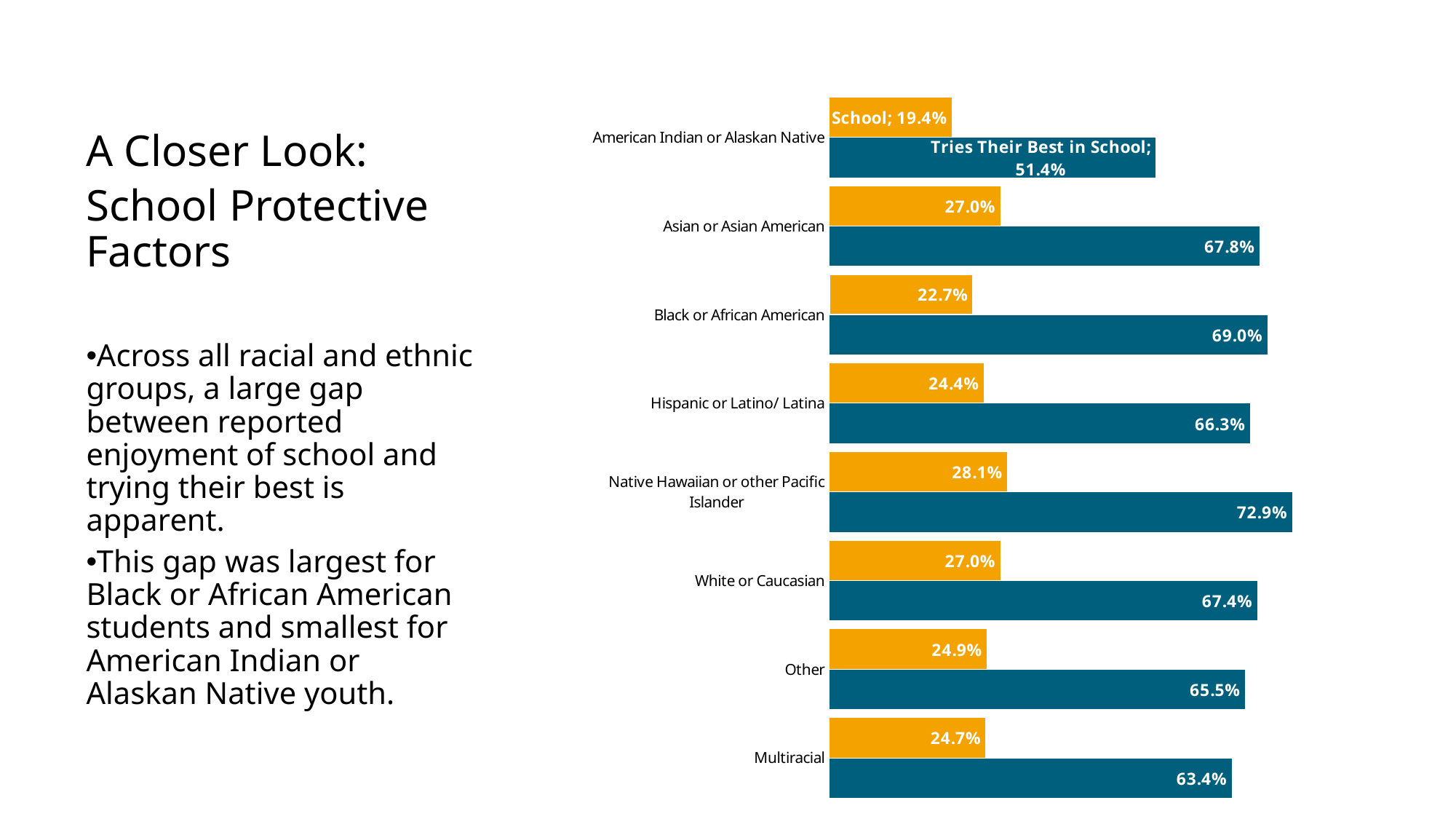
What is the difference between the 'Tries Their Best in School' value and the orange 'School' value for American Indian or Alaskan Native students? 32.0 percentage points What is the value of the 'Tries Their Best in School' bar for Multiracial students? 63.4% Which is larger: the 'Tries Their Best in School' value for Hispanic or Latino/ Latina students or for Other students? Hispanic or Latino/ Latina Which group has the lowest 'Tries Their Best in School' value? American Indian or Alaskan Native Which group has the highest 'Tries Their Best in School' value? Native Hawaiian or other Pacific Islander What is the value of the orange 'School' bar for American Indian or Alaskan Native students? 19.4% What type of chart is shown on the slide? Bar chart Which group has the highest value on the orange 'School' bars? Native Hawaiian or other Pacific Islander What is the value of the 'Tries Their Best in School' bar for Black or African American students? 69.0% How many racial or ethnic groups are shown on the chart? 8 What is the difference between the 'Tries Their Best in School' value and the orange 'School' value for Black or African American students? 46.3 percentage points What colour are the 'Tries Their Best in School' bars? Dark teal blue